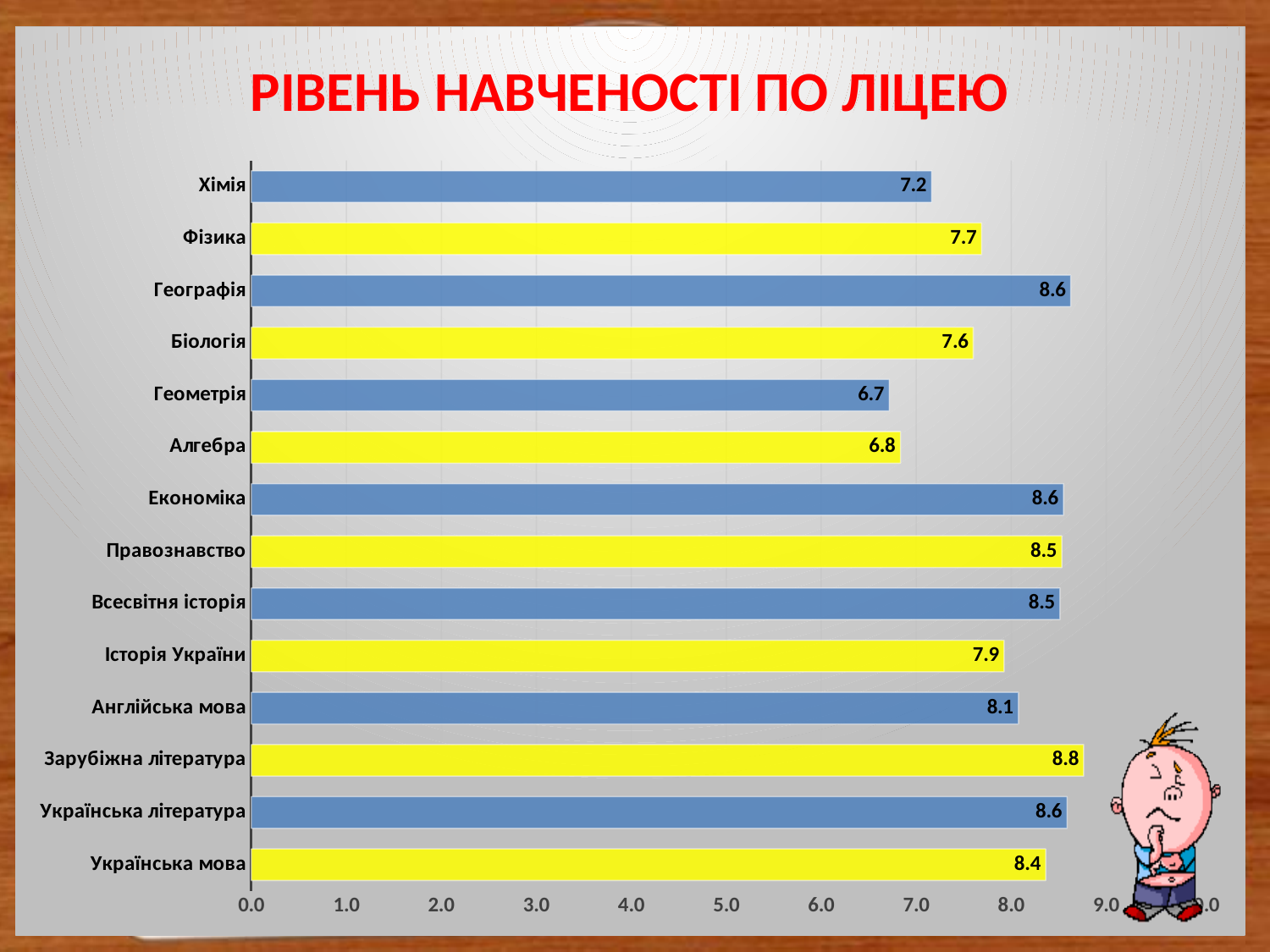
Which subject has the highest value? Зарубіжна література What kind of chart is shown on the slide? Bar chart What is the difference between the values for Зарубіжна література and Геометрія? 2.1 What is the difference between the values for Фізика and Хімія? 0.5 What is the value for Зарубіжна література? 8.8 How many subjects are shown in the chart? 14 What is the title of the chart? РІВЕНЬ НАВЧЕНОСТІ ПО ЛІЦЕЮ What is the value for Хімія? 7.2 What is the value for Геометрія? 6.7 Which is larger, the value for Англійська мова or the value for Українська мова? Українська мова What is the value for Історія України? 7.9 Which subject has the lowest value? Геометрія